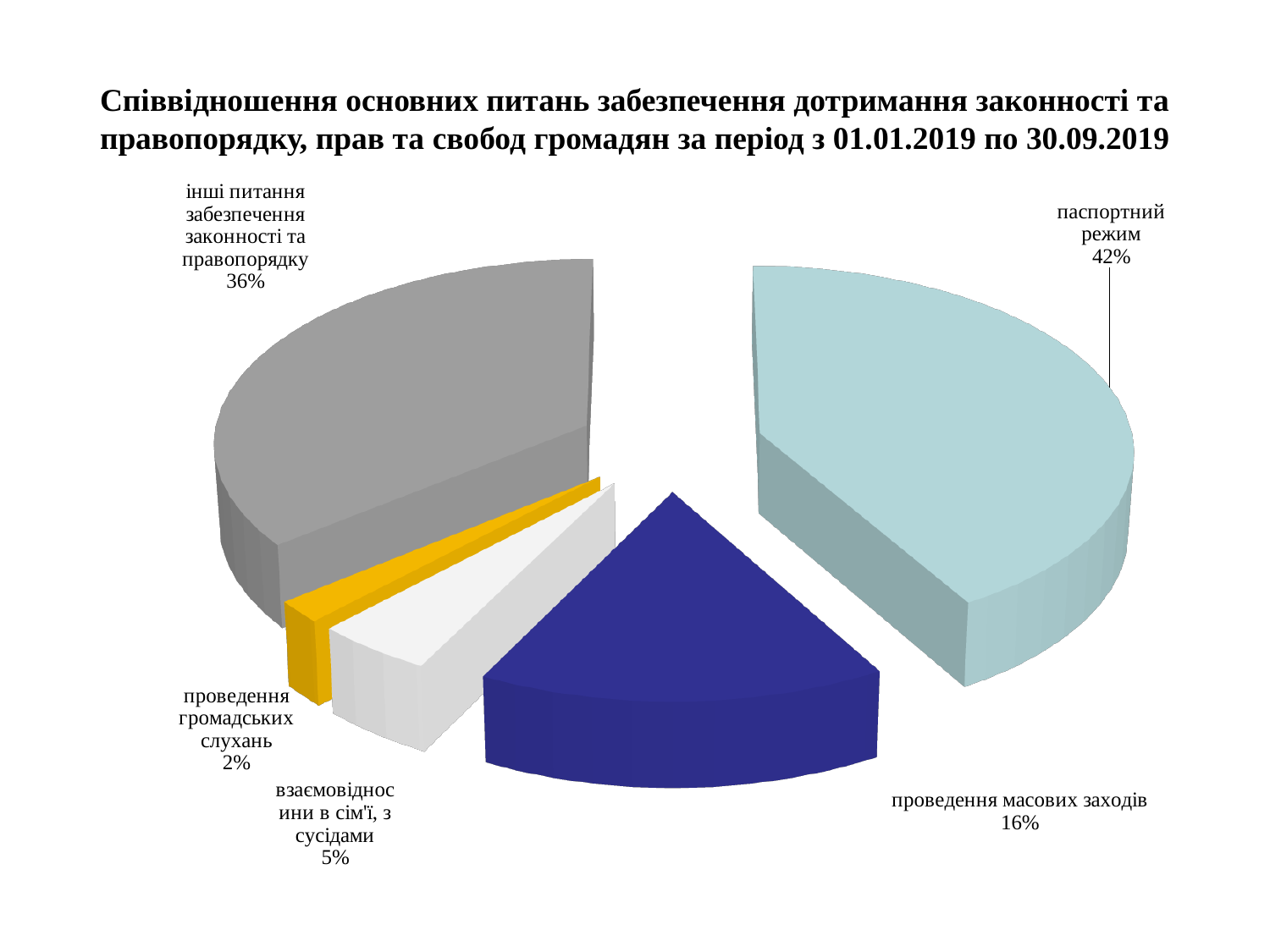
What is the value shown for "проведення громадських слухань"? 2% What is the value shown for "взаємовідносини в сім'ї, з сусідами"? 5% What share of the pie does "інші питання забезпечення законності та правопорядку" have? 36% Which category has the smallest share of the pie? проведення громадських слухань What colour is the slice for "проведення масових заходів"? dark blue Which category has the largest share of the pie? паспортний режим What kind of chart is shown on the slide? pie chart Which is larger: "проведення масових заходів" or "взаємовідносини в сім'ї, з сусідами"? проведення масових заходів What is the value shown for "проведення масових заходів"? 16% How many slices does the pie chart have? 5 What is the difference in percentage points between "паспортний режим" and "інші питання забезпечення законності та правопорядку"? 6% What share of the pie does "паспортний режим" have? 42%